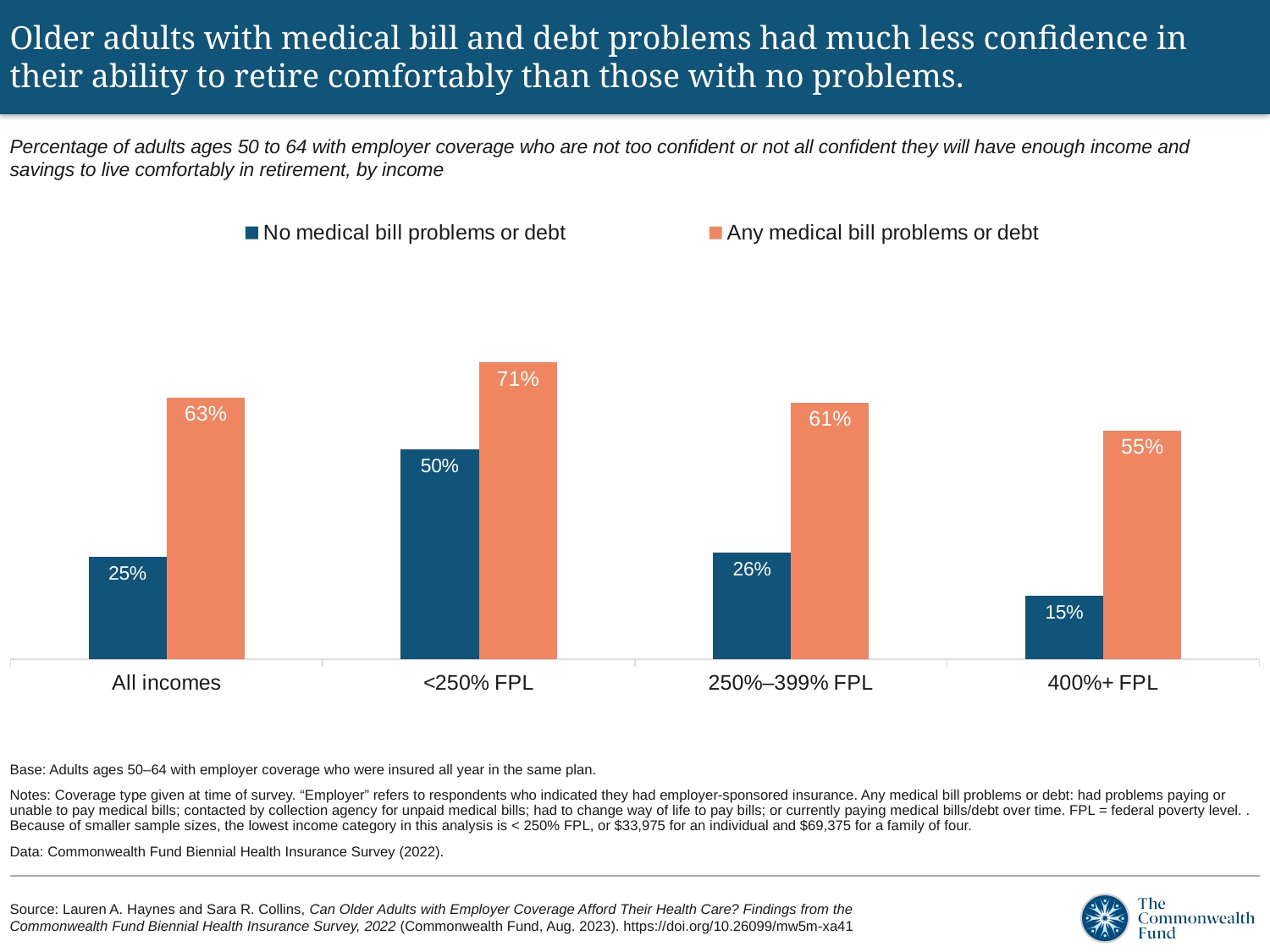
What percentage of adults with no medical bill problems or debt in the All incomes group are not confident about retirement income? 25% What is the value for 'Any medical bill problems or debt' in the <250% FPL category? 71% How many income categories are shown on the x axis? 4 What is the difference between the two series in the All incomes category? 38 percentage points Which is larger: the 'No medical bill problems or debt' value for <250% FPL or for 250%–399% FPL? <250% FPL How many series does the legend list? 2 What kind of chart is shown on the slide? Bar chart What is the value for 'No medical bill problems or debt' in the 400%+ FPL category? 15% Which income category has the highest value for 'Any medical bill problems or debt'? <250% FPL Which income category has the lowest value for 'No medical bill problems or debt'? 400%+ FPL What is the difference between the 'Any medical bill problems or debt' and 'No medical bill problems or debt' values in the 400%+ FPL category? 40 percentage points What is the value for 'Any medical bill problems or debt' in the 250%–399% FPL category? 61%